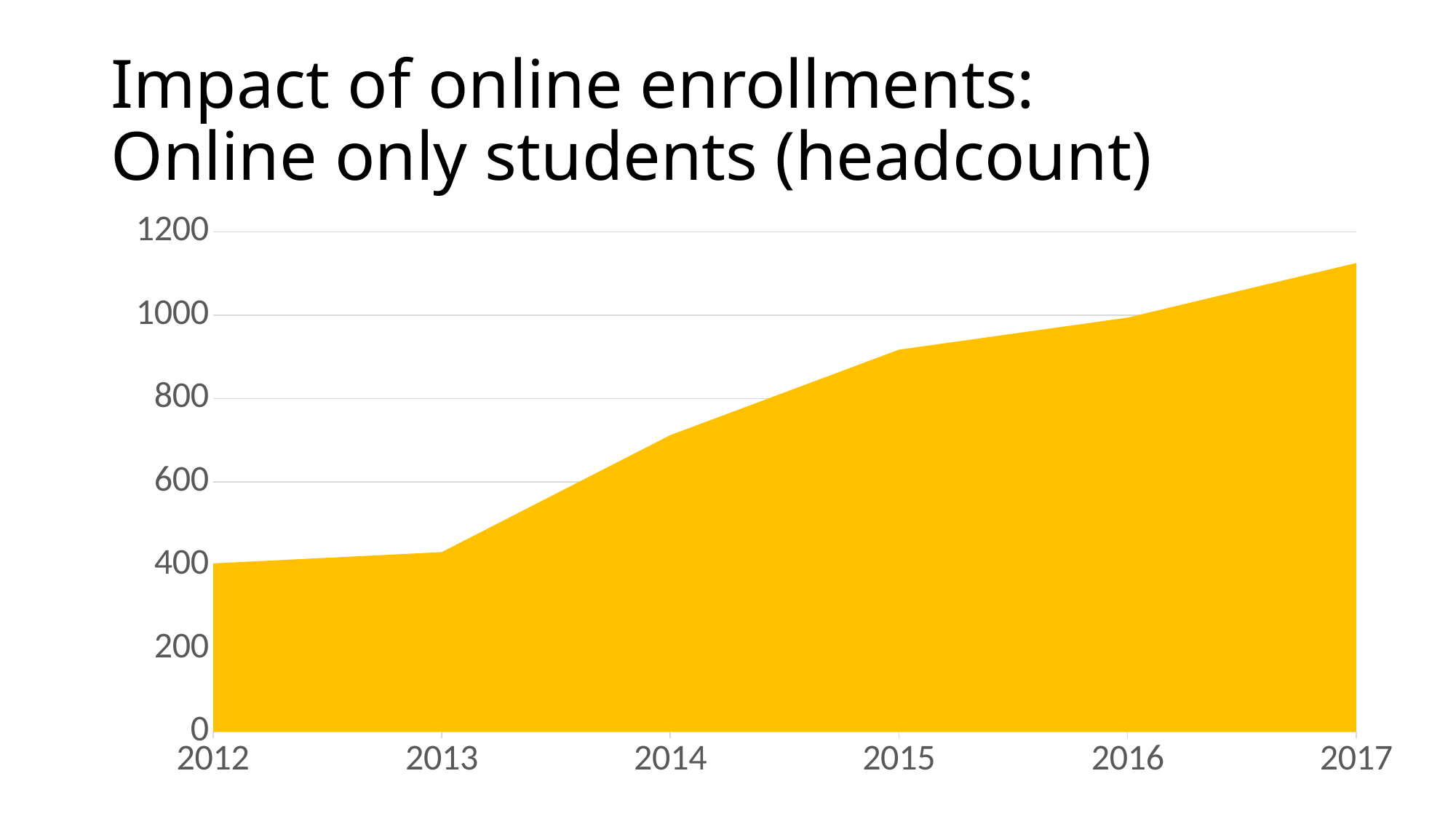
How many years are plotted along the x axis? 6 Do the values rise or fall from 2012 to 2017? Rise Which is larger, the value for 2015 or the value for 2013? 2015 What kind of chart is shown on the slide? Area chart Is the value for 2014 greater or less than 600? greater Is the value for 2017 greater or less than 1000? greater Which year has the lowest online only student headcount? 2012 Is the value for 2015 greater or less than 800? greater What is the title of the chart? Impact of online enrollments: Online only students (headcount) Which year has the highest online only student headcount? 2017